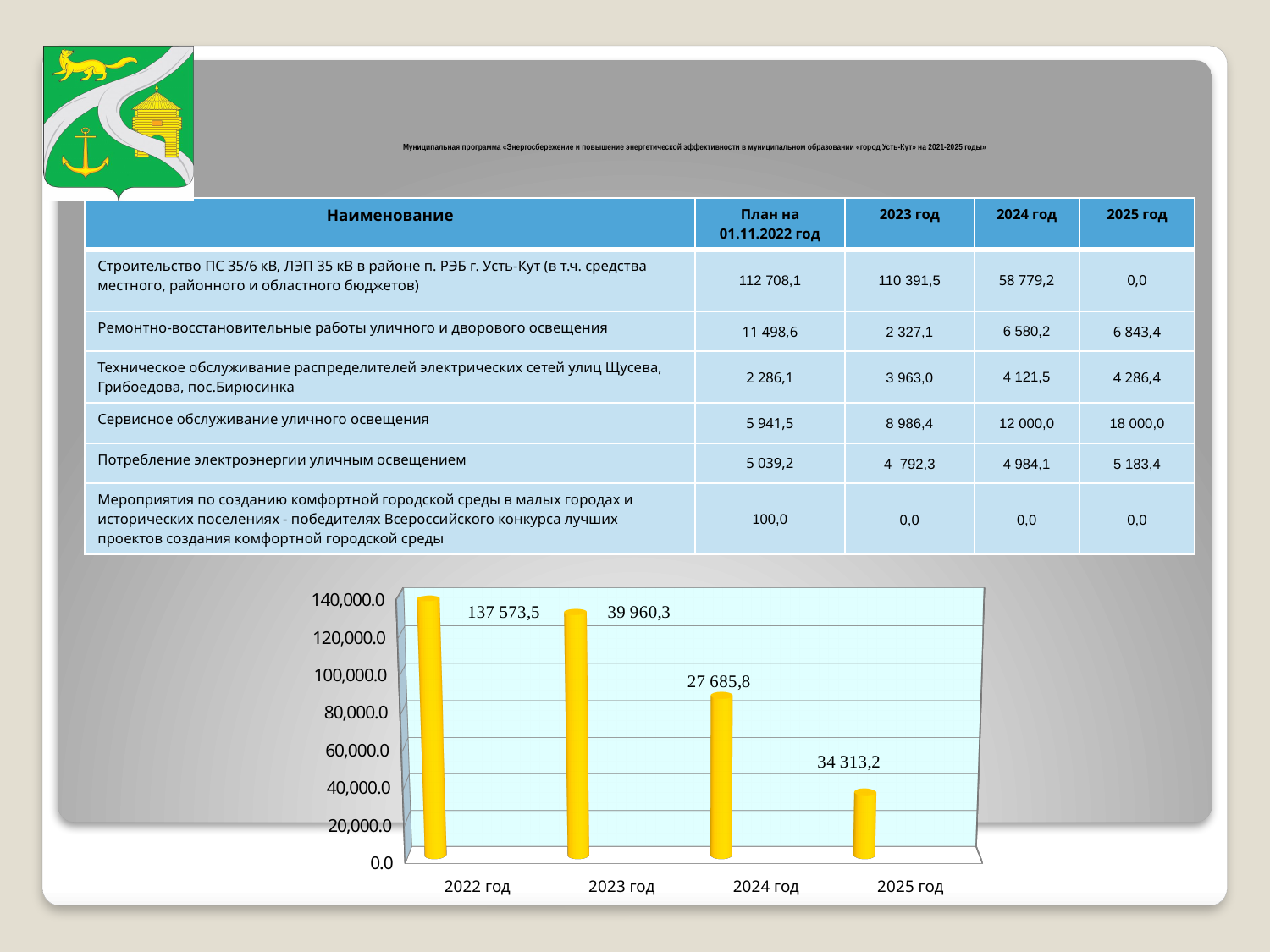
What is the highest value shown on the chart's vertical axis? 140,000.0 What is the value shown for 2025 год in the chart? 34 313,2 What colour are the bars in the chart? yellow What type of chart is shown at the bottom of the slide? bar chart What is the value shown for 2022 год in the chart? 137 573,5 Is the value for 2022 год greater or less than 120,000.0? greater Is the value for 2025 год greater or less than 40,000.0? less How many bars (years) does the chart show? 4 Which year has the highest bar in the chart? 2022 год What is the difference between the values for 2022 год and 2025 год in the chart? 103 260,3 Which is larger in the chart, the value for 2022 год or for 2025 год? 2022 год